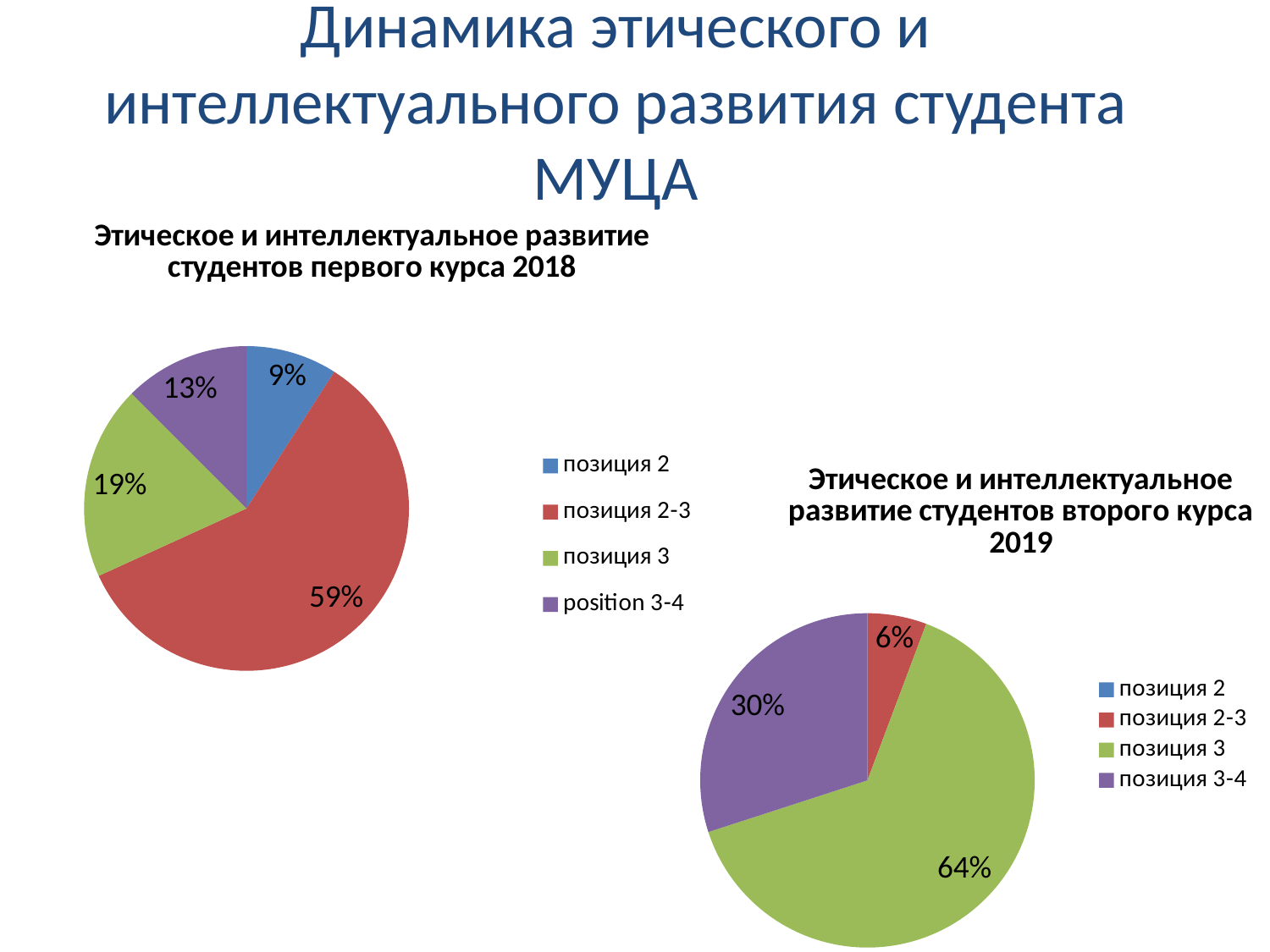
In the 2019 second-year chart, what share is labelled for позиция 3-4? 30% In the 2019 second-year chart, what share is labelled for позиция 2-3? 6% How many entries does the legend of the 2018 first-year chart list? 4 In the 2019 second-year chart, what share is labelled for позиция 3? 64% In the 2019 second-year chart, which is larger, the slice for позиция 3 or the slice for позиция 3-4? позиция 3 In the 2018 first-year chart, what share is labelled for позиция 3? 19% In the 2018 first-year chart, what share is labelled for позиция 2-3? 59% In the 2018 first-year chart, which category has the largest slice? позиция 2-3 What kind of chart is used for the 2019 second-year data? Pie chart In the 2018 first-year chart, which category has the smallest slice? позиция 2 In the 2018 first-year chart, what share is labelled for position 3-4? 13% In the 2018 first-year chart, what is the difference between the shares for позиция 2-3 and позиция 3? 40%